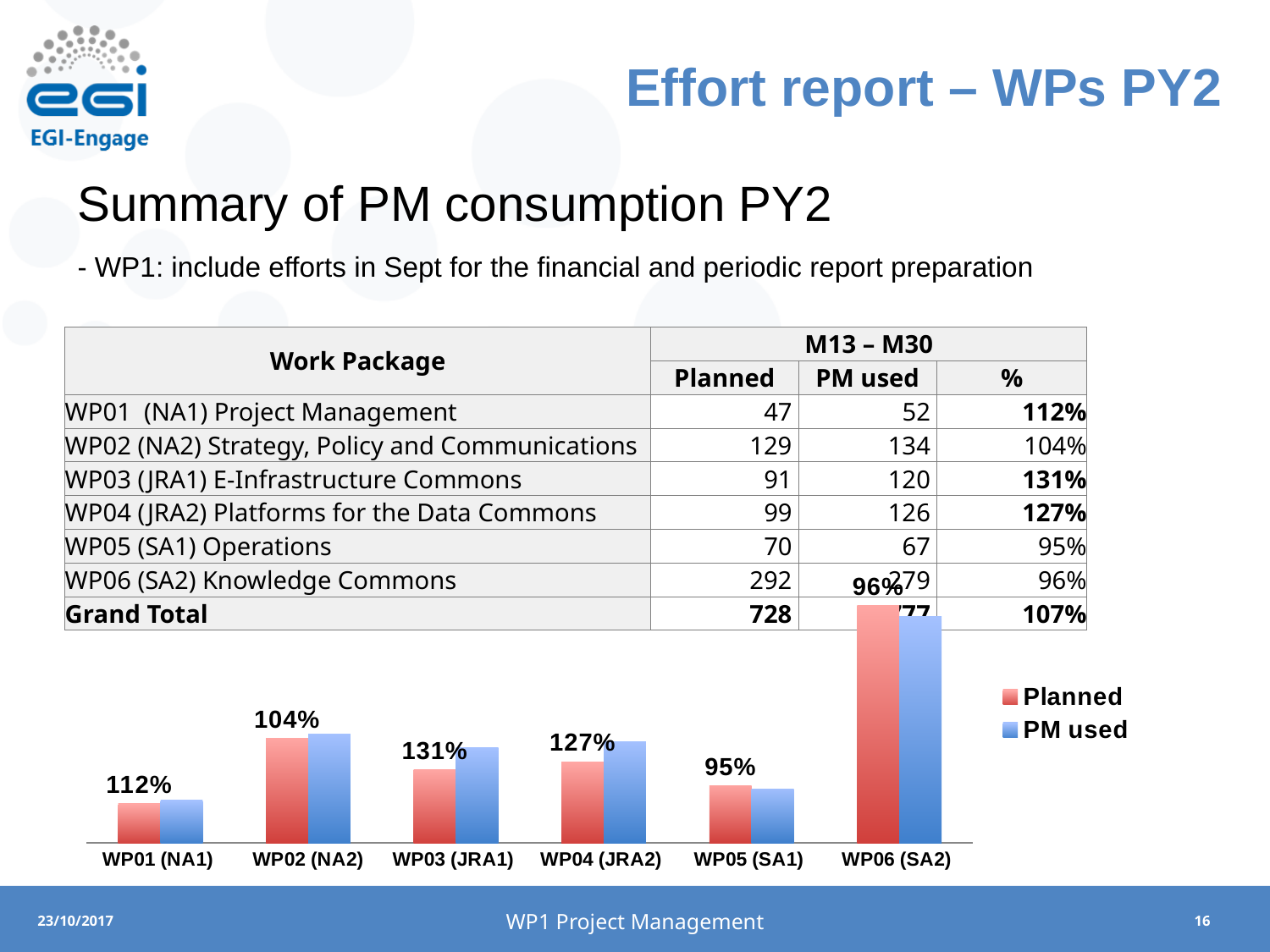
How many series does the chart legend list? 2 Which work package has the lowest percentage label in the chart? WP05 (SA1) What is the difference between the percentage labels for WP03 (JRA1) and WP04 (JRA2)? 4 percentage points What percentage label is shown for WP05 (SA1) in the chart? 95% For WP03 (JRA1), which bar is taller: Planned or PM used? PM used How many work packages are shown on the x axis of the chart? 6 Which work package has the tallest Planned bar in the chart? WP06 (SA2) What percentage label is shown above the bars for WP03 (JRA1) in the chart? 131% Which work package has the highest percentage label in the chart? WP03 (JRA1) What percentage label is shown for WP01 (NA1) in the chart? 112% Which work package has the shortest Planned bar in the chart? WP01 (NA1) What type of chart is shown on the slide? Bar chart